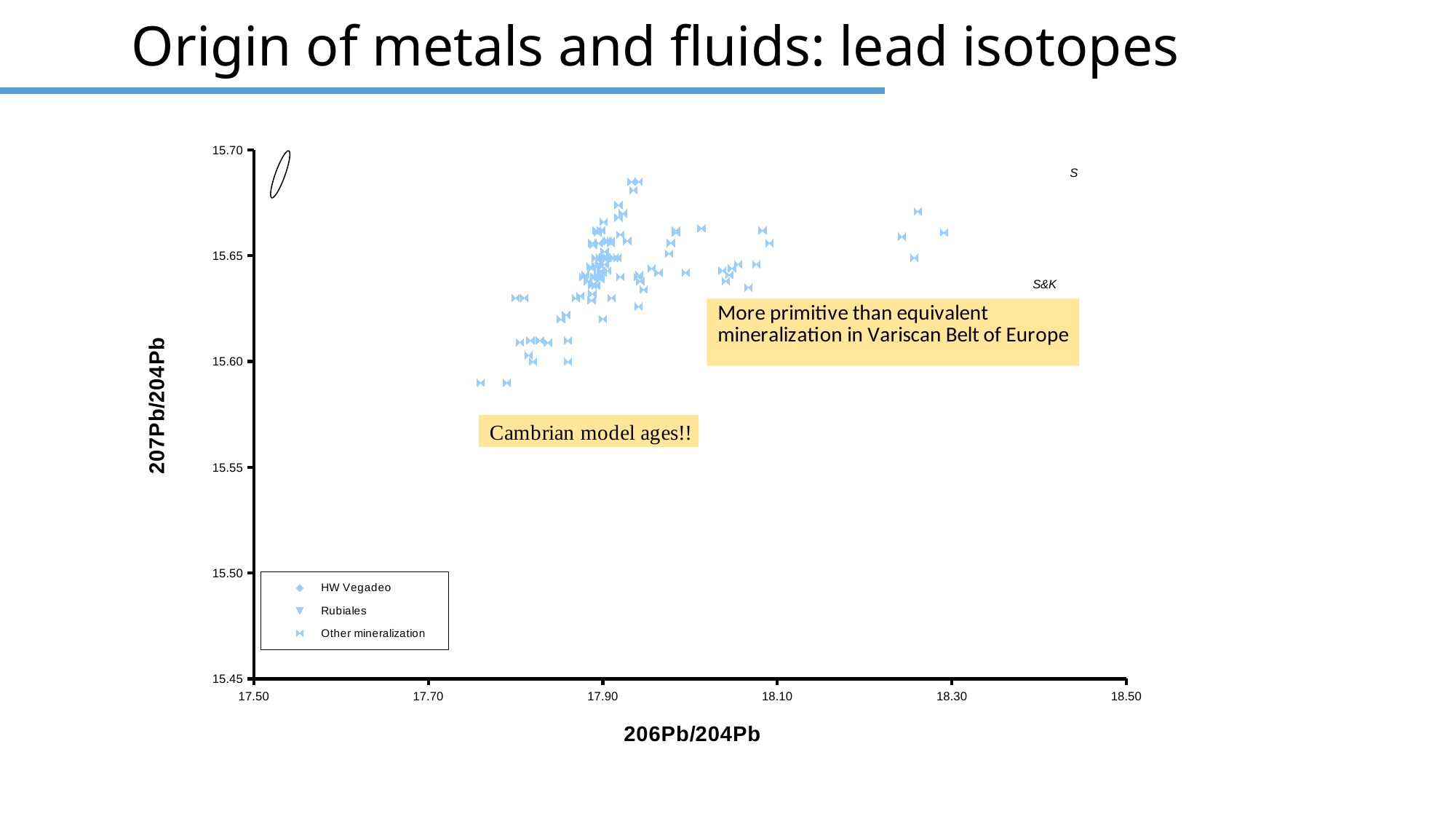
What is the label of the chart's x axis? 206Pb/204Pb Is the lowest plotted 207Pb/204Pb value greater or less than 15.55? greater What are the three series named in the chart legend? HW Vegadeo, Rubiales, Other mineralization What kind of chart is shown on the slide? scatter chart Is the highest plotted 207Pb/204Pb value greater or less than 15.70? less Is the 206Pb/204Pb value of the leftmost plotted point greater or less than 17.70? greater How many series does the chart legend list? 3